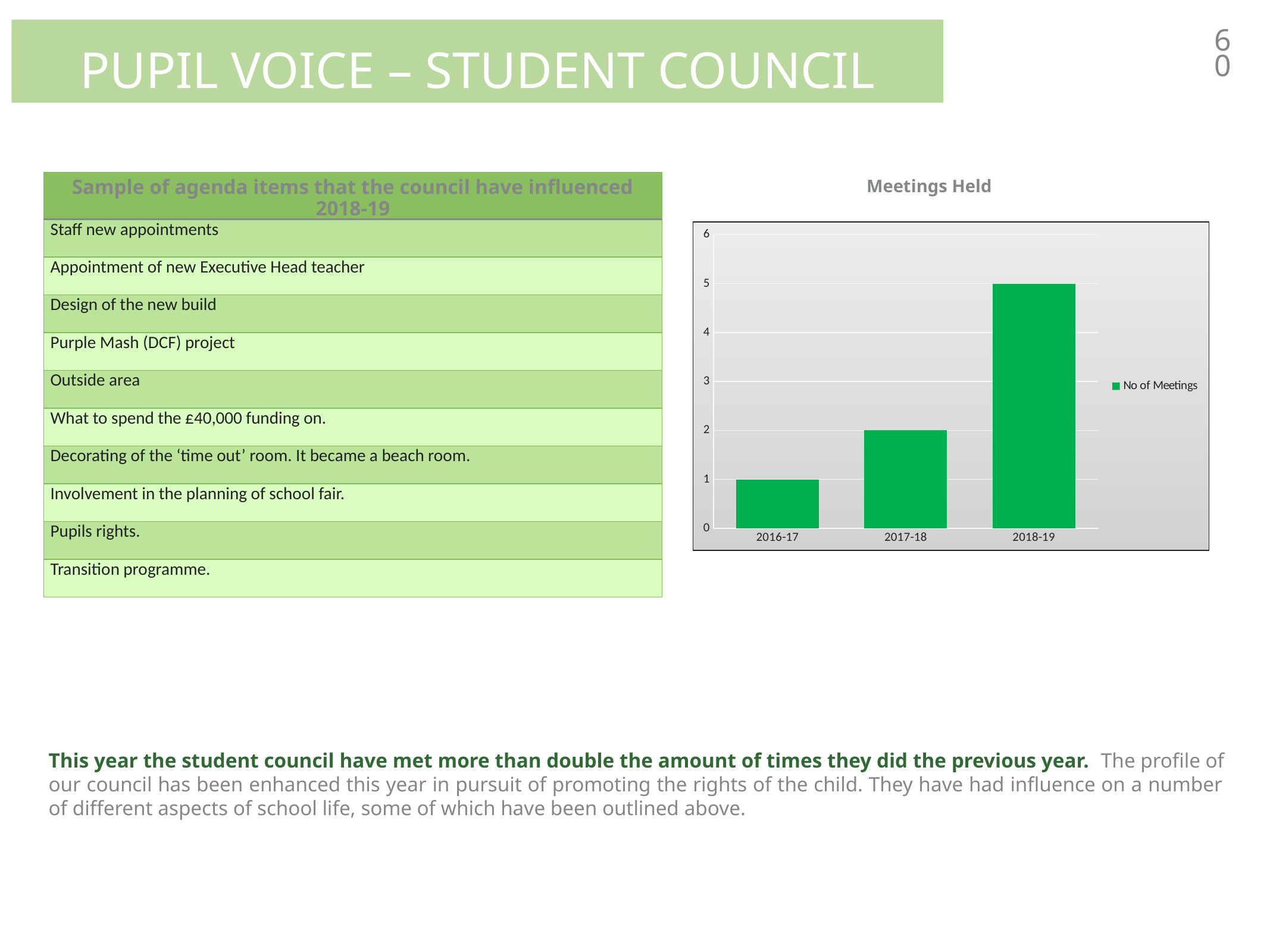
How many meetings were held in 2016-17? 1 How many meetings were held in 2018-19? 5 Which year had the lowest number of meetings? 2016-17 What series name is listed in the chart's legend? No of Meetings What is the difference in the number of meetings between 2018-19 and 2017-18? 3 Which year had more meetings, 2016-17 or 2017-18? 2017-18 How many meetings were held in 2017-18? 2 How many years are shown on the x axis of the chart? 3 Which year had the highest number of meetings? 2018-19 Is the number of meetings in 2018-19 greater or less than 4? greater Do the number of meetings rise or fall from 2016-17 to 2018-19? rise What type of chart is shown under the title "Meetings Held"? bar chart